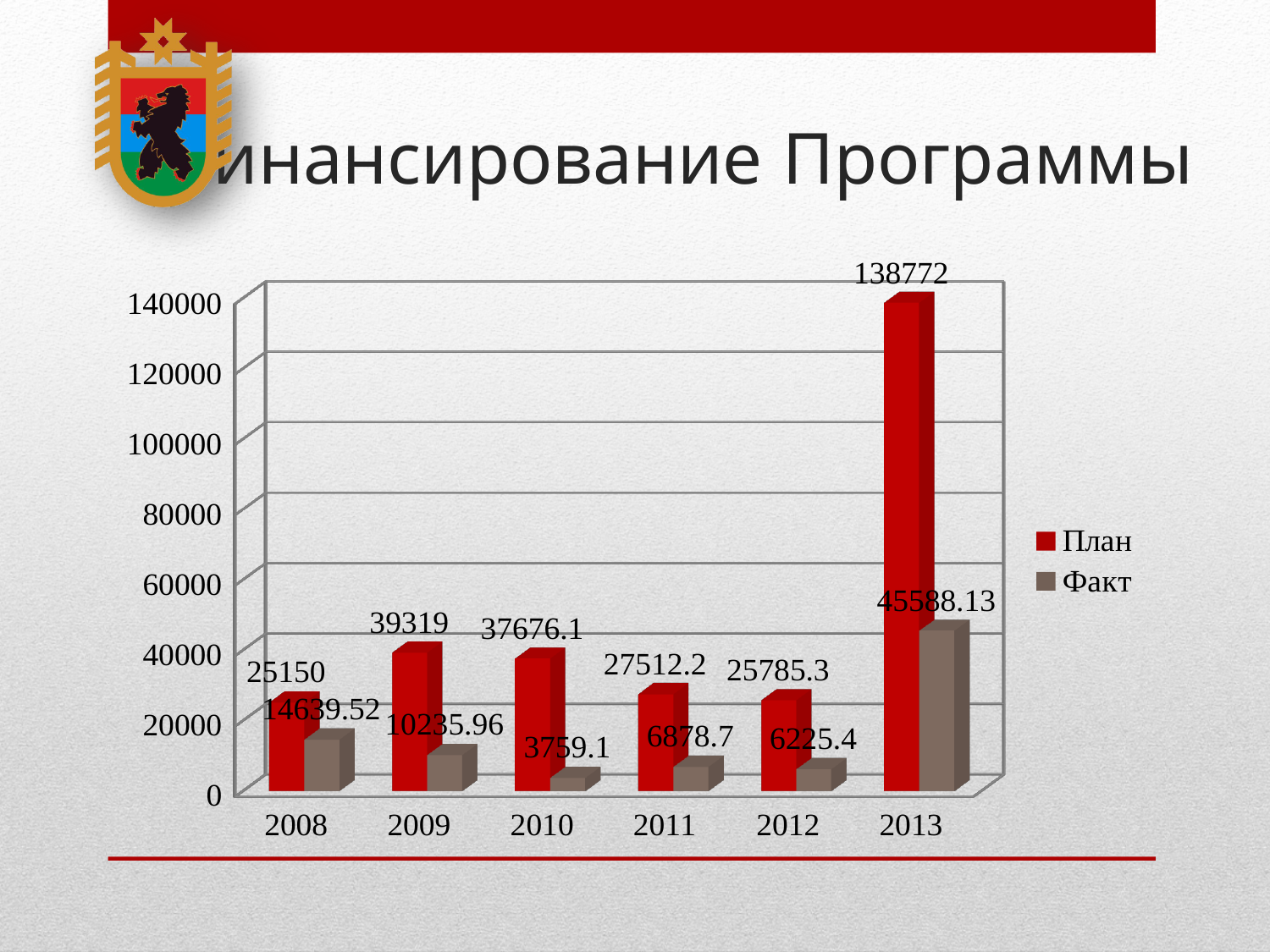
What is the Факт value for 2010? 3759.1 Which is larger, the Факт value for 2011 or for 2012? 2011 What is the План value for 2011? 27512.2 Which year has the lowest Факт value? 2010 What is the Факт value for 2008? 14639.52 How many years are shown on the x axis? 6 What kind of chart is shown on the slide? Bar chart How many series does the legend list? 2 What is the difference between the План and Факт values for 2013? 93183.87 What is the План value for 2013? 138772 What is the difference between the План values for 2009 and 2010? 1642.9 Which year has the highest План value? 2013